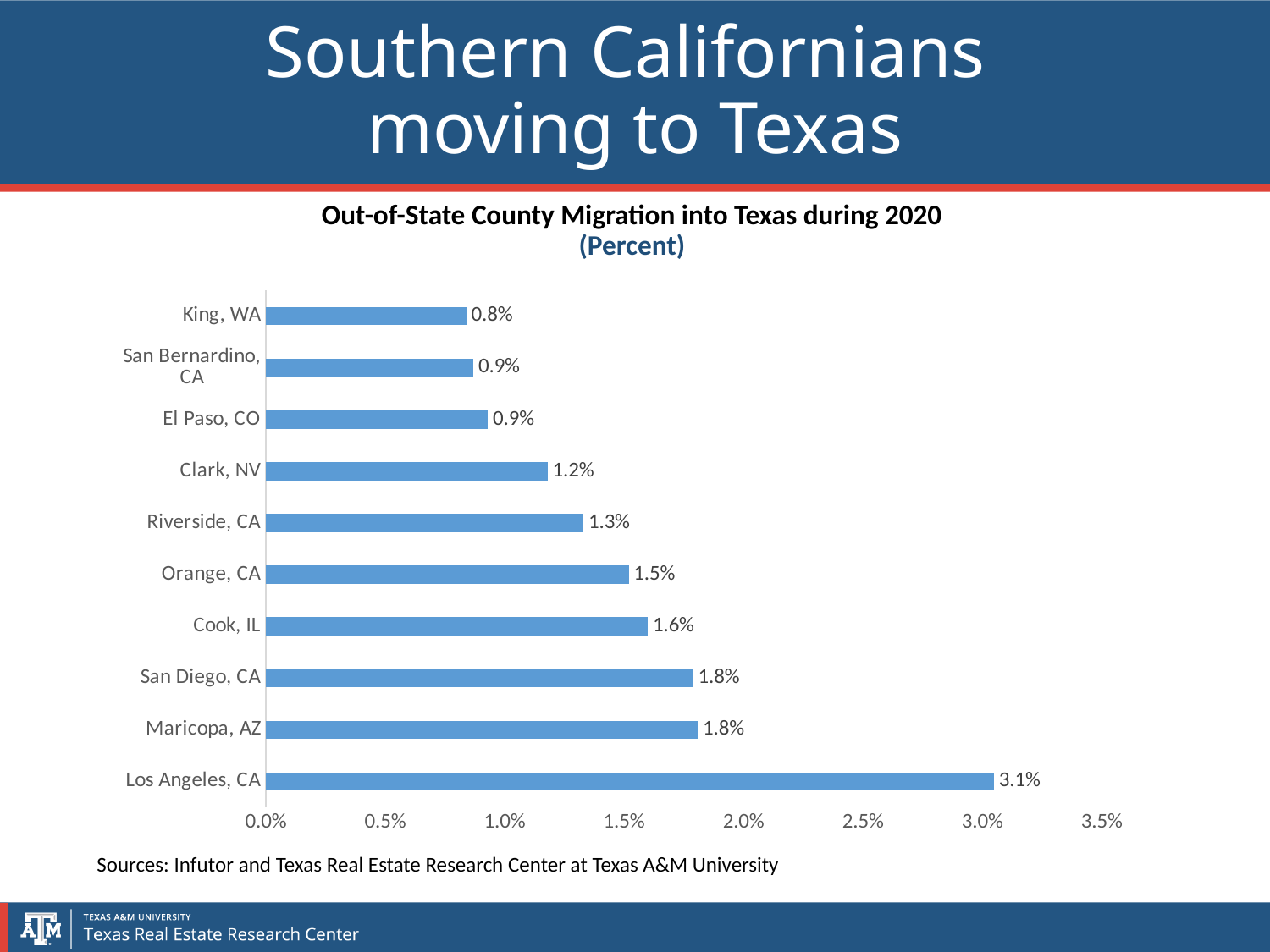
What kind of chart is shown on the slide? bar chart What is the value for King, WA? 0.8% Is the value for Maricopa, AZ greater or less than 1.5%? greater What is the value for Los Angeles, CA? 3.1% What is the title of the chart? Out-of-State County Migration into Texas during 2020 (Percent) What is the value for Clark, NV? 1.2% How many counties are shown in the chart? 10 Which county has the highest value? Los Angeles, CA Which county has the lowest value? King, WA What is the difference between the values for Los Angeles, CA and San Diego, CA? 1.3% Which is larger, the value for Orange, CA or the value for Riverside, CA? Orange, CA What is the value for Cook, IL? 1.6%